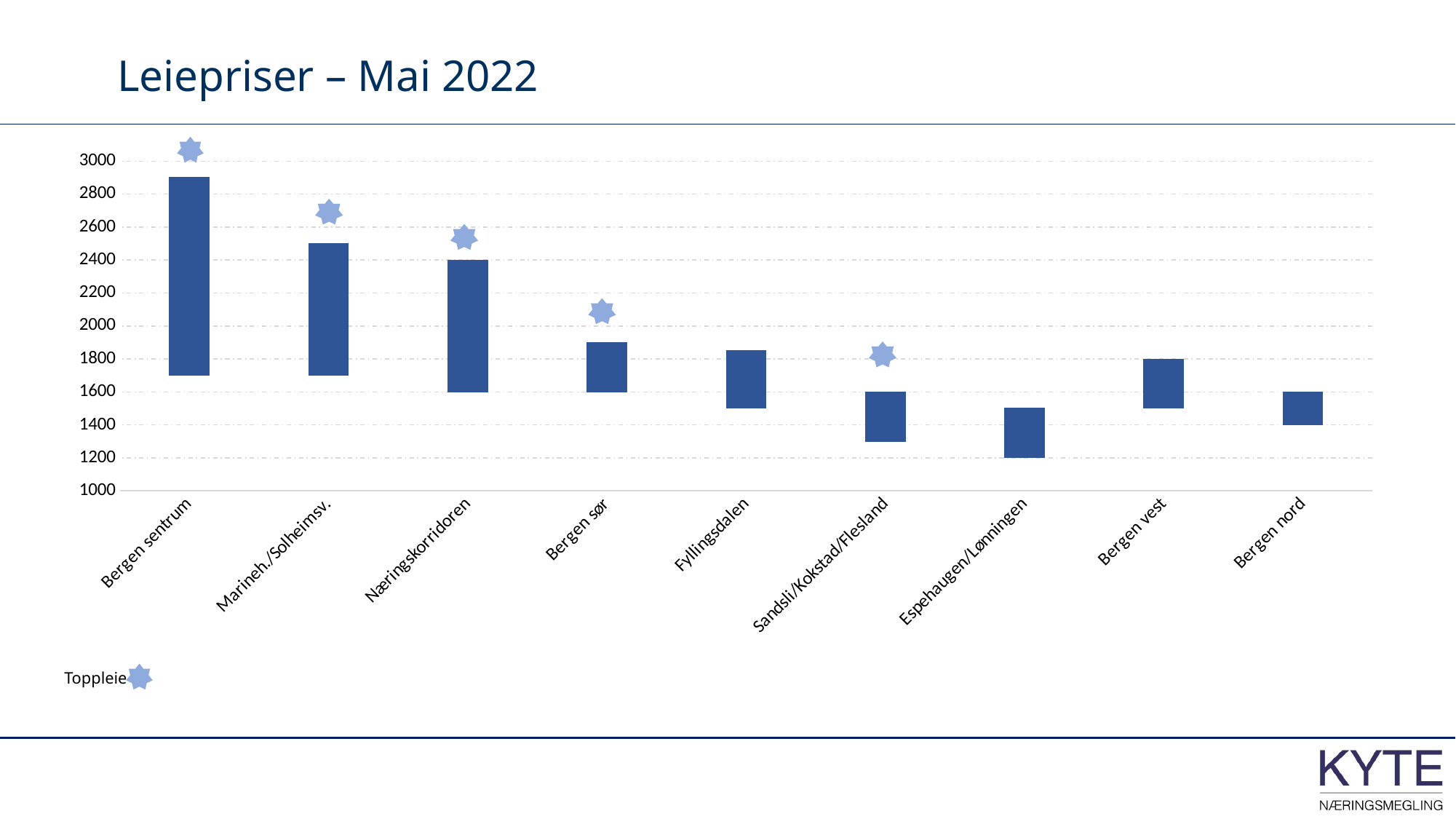
How many areas (categories) are shown on the x axis? 9 What does the star marker in the legend represent? Toppleie Is the top of the bar for Bergen sentrum greater or less than 2800? greater What value does the bottom of the bar for Bergen nord start at? 1400 Is the top of the bar for Fyllingsdalen greater or less than 2000? less What value does the top of the bar for Bergen nord reach? 1600 Is the top of the bar for Marineh./Solheimsv. greater or less than 2400? greater Which bar reaches higher at its top, Bergen sør or Sandsli/Kokstad/Flesland? Bergen sør Which area has the lowest bottom of its bar? Espehaugen/Lønningen What kind of chart is shown on the slide? bar chart What value does the top of the bar for Næringskorridoren reach? 2400 Which area has the highest top of its bar? Bergen sentrum